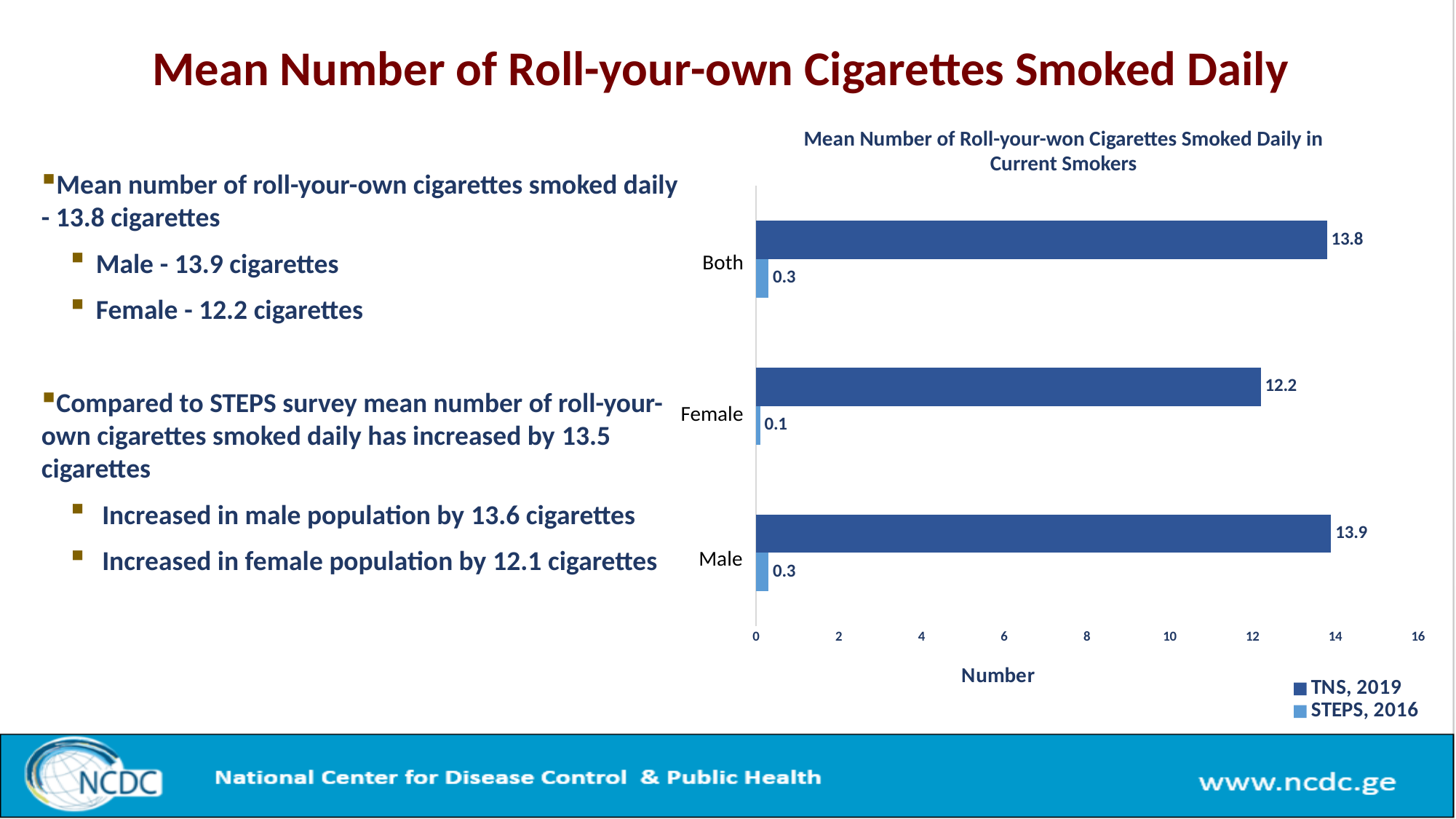
What is the difference between the TNS, 2019 and STEPS, 2016 values for Male? 13.6 What is the STEPS, 2016 value for Both? 0.3 What is the TNS, 2019 value for Both? 13.8 What is the difference between the TNS, 2019 values for Male and Female? 1.7 What is the TNS, 2019 value for Male? 13.9 How many series does the legend list? 2 What is the STEPS, 2016 value for Female? 0.1 Which is larger, the TNS, 2019 value for Female or the TNS, 2019 value for Both? Both How many categories are shown on the chart? 3 Which category has the lowest TNS, 2019 value? Female Which category has the lowest STEPS, 2016 value? Female What kind of chart is shown on the slide? Bar chart